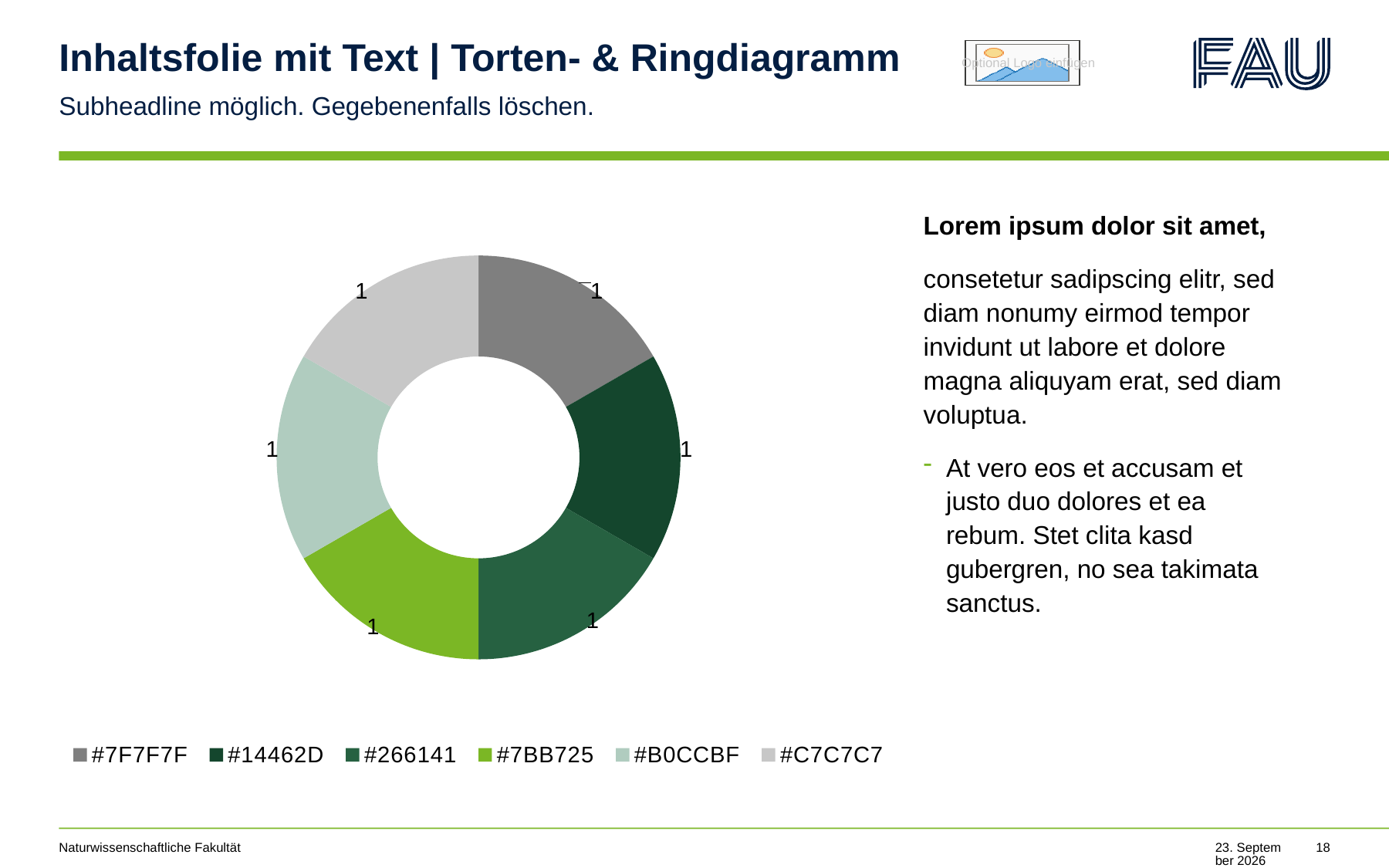
What is the total of all slice values in the doughnut chart? 6 Are all slices of the doughnut chart the same size? Yes What is the value of the #14462D slice in the doughnut chart? 1 How many slices does the doughnut chart have? 6 What is the value of the #7F7F7F slice in the doughnut chart? 1 What is the value of the #7BB725 slice in the doughnut chart? 1 Which legend entry is shown in the lightest grey colour? #C7C7C7 What kind of chart is shown on the slide? Doughnut chart How many entries does the legend of the doughnut chart list? 6 What is the difference between the values of the #266141 and #B0CCBF slices? 0 What is the value of the #C7C7C7 slice in the doughnut chart? 1